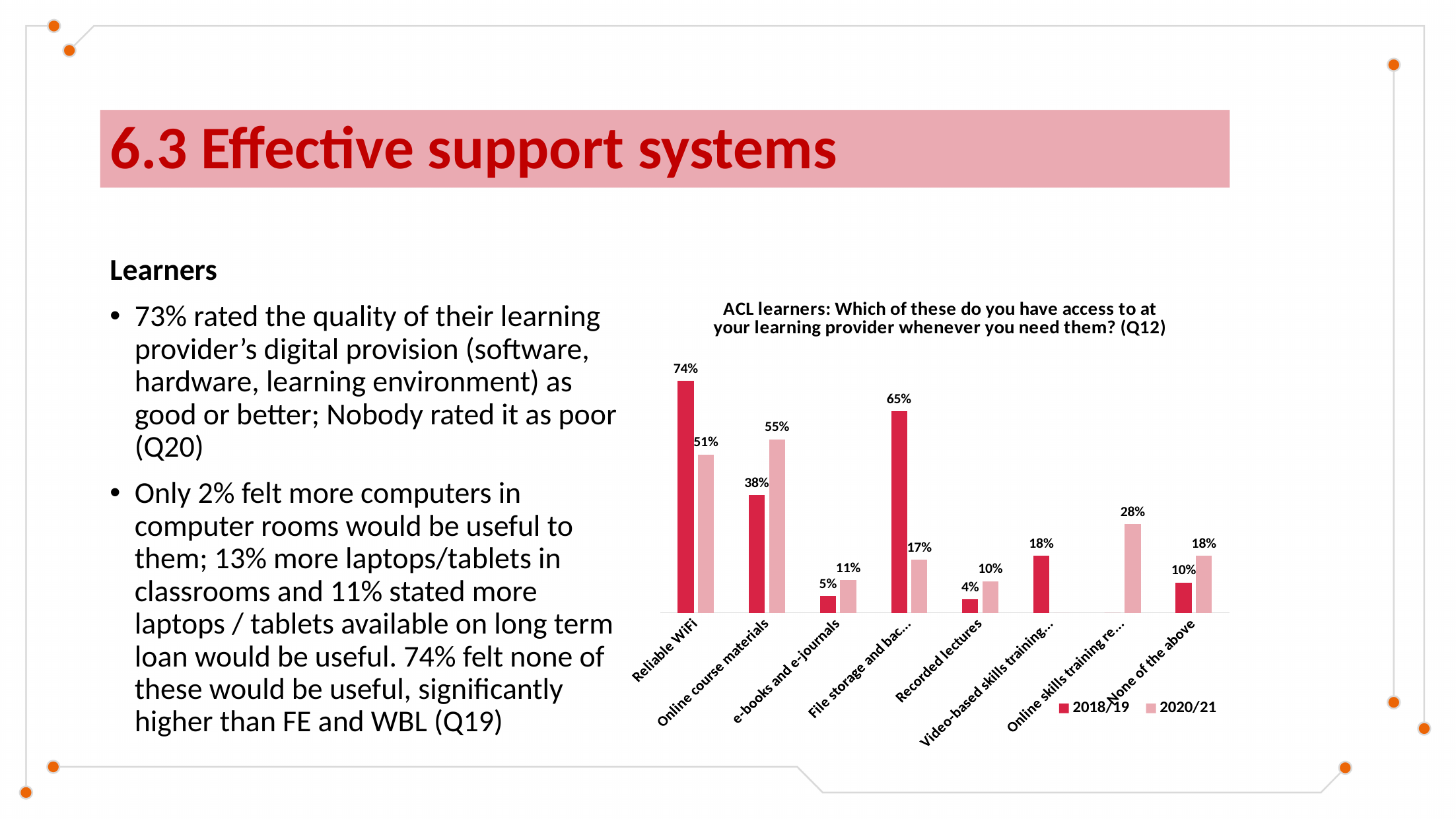
What are the two series named in the legend? 2018/19 and 2020/21 What is the 2020/21 value for Online course materials? 55% Which category has the highest 2018/19 value? Reliable WiFi Which category has the lowest 2020/21 value among those with a 2020/21 bar? Recorded lectures What kind of chart is shown? Bar chart What is the 2020/21 value for Recorded lectures? 10% What is the 2018/19 value for Reliable WiFi? 74% What is the difference between the 2018/19 and 2020/21 values for Reliable WiFi? 23% How many series does the legend list? 2 What is the 2018/19 value for None of the above? 10% Which is larger for Online course materials: the 2018/19 value or the 2020/21 value? 2020/21 How many categories are shown on the x axis? 8